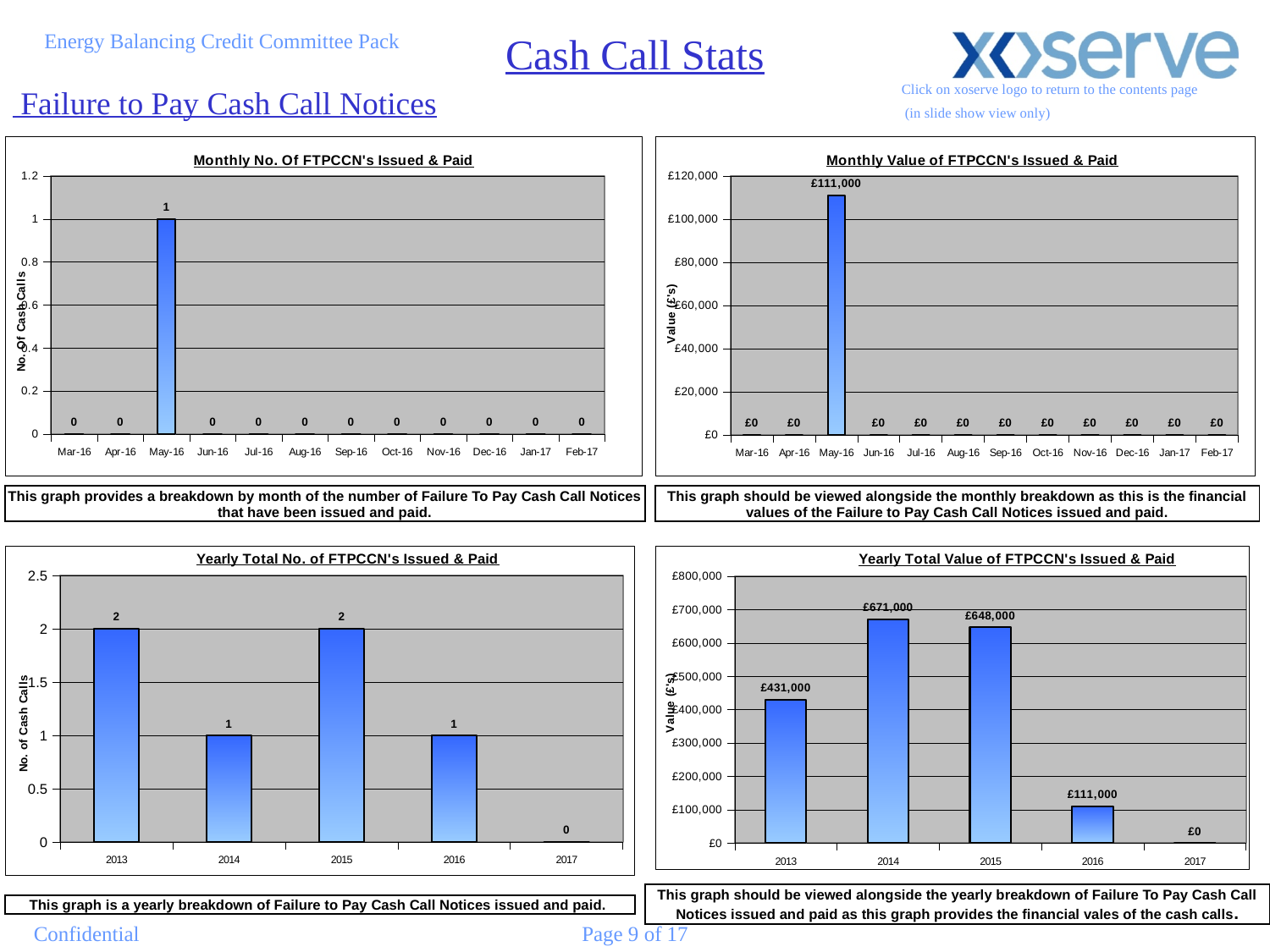
What kind of chart is the 'Yearly Total Value of FTPCCN's Issued & Paid' chart? bar chart In the 'Yearly Total Value of FTPCCN's Issued & Paid' chart, what is the difference between the values for 2014 and 2015? £23,000 In the 'Monthly No. Of FTPCCN's Issued & Paid' chart, how many months are shown on the x axis? 12 In the 'Monthly Value of FTPCCN's Issued & Paid' chart, what is the value for May-16? £111,000 In the 'Monthly No. Of FTPCCN's Issued & Paid' chart, what is the value for May-16? 1 In the 'Yearly Total No. of FTPCCN's Issued & Paid' chart, which year has the lowest value? 2017 In the 'Yearly Total Value of FTPCCN's Issued & Paid' chart, is the value for 2013 greater or less than £400,000? greater In the 'Monthly Value of FTPCCN's Issued & Paid' chart, which month has the highest value? May-16 In the 'Yearly Total No. of FTPCCN's Issued & Paid' chart, what is the value for 2014? 1 In the 'Yearly Total Value of FTPCCN's Issued & Paid' chart, what is the value for 2015? £648,000 In the 'Yearly Total Value of FTPCCN's Issued & Paid' chart, which is larger, the value for 2013 or the value for 2016? 2013 In the 'Yearly Total Value of FTPCCN's Issued & Paid' chart, which year has the highest value? 2014